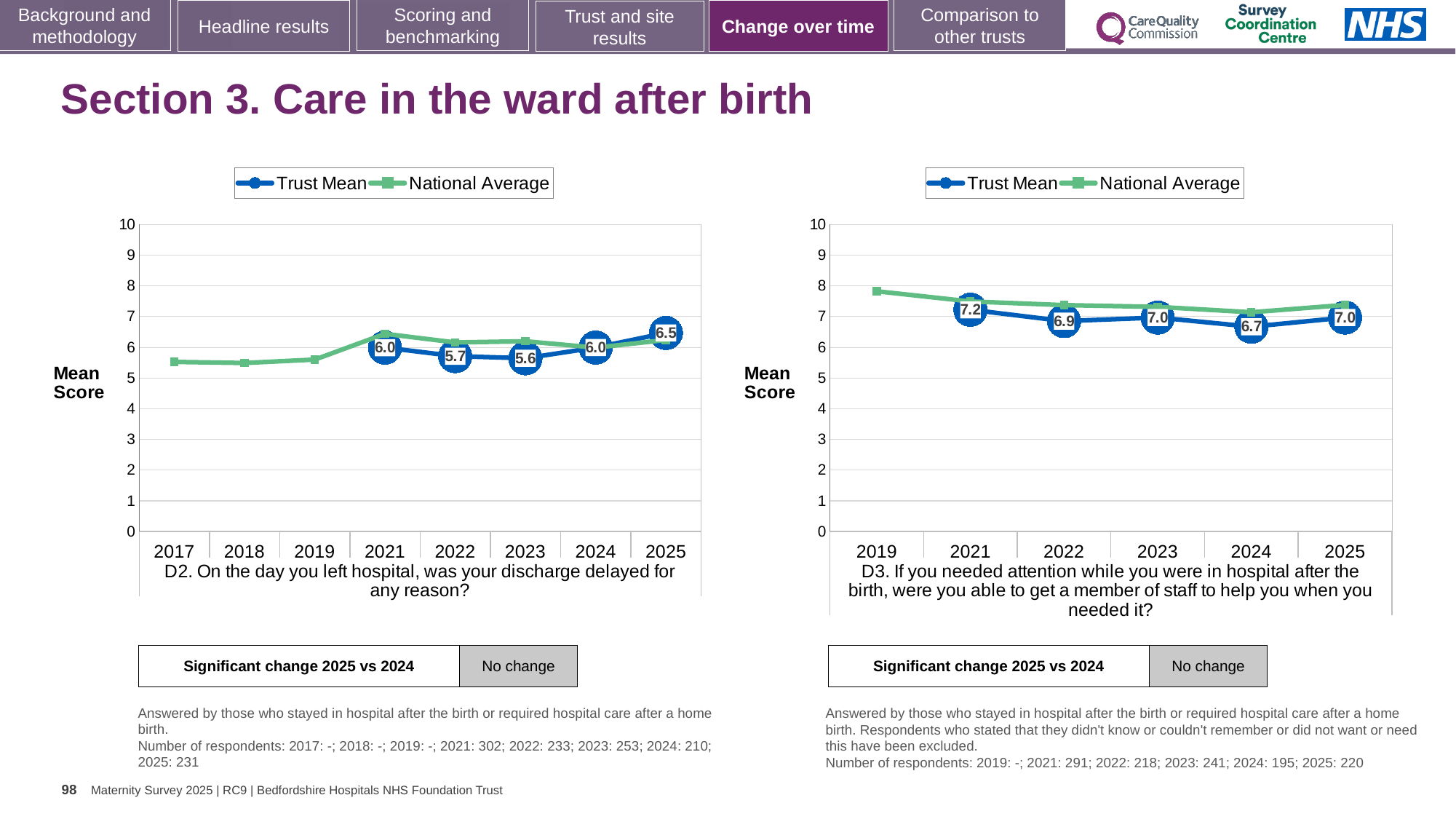
How many series does the legend of the D3 chart (right) list? 2 In the D3 chart (right), what is the Trust Mean for 2021? 7.2 In the D3 chart (right), which year has the lowest labelled Trust Mean? 2024 In the D3 chart (right), is the National Average for 2019 greater or less than 7? greater In the D2 chart (left), what is the Trust Mean for 2025? 6.5 In the D2 chart (left), what is the difference between the Trust Mean for 2025 and the Trust Mean for 2023? 0.9 In the D3 chart (right), what is the Trust Mean for 2024? 6.7 In the D2 chart (left), which year has the highest labelled Trust Mean? 2025 In the D2 chart (left), what is the Trust Mean for 2023? 5.6 What kind of chart is the D2 chart (left)? Line chart In the D3 chart (right), which is larger: the Trust Mean for 2021 or the Trust Mean for 2022? 2021 How many years are shown on the x axis of the D2 chart (left)? 8